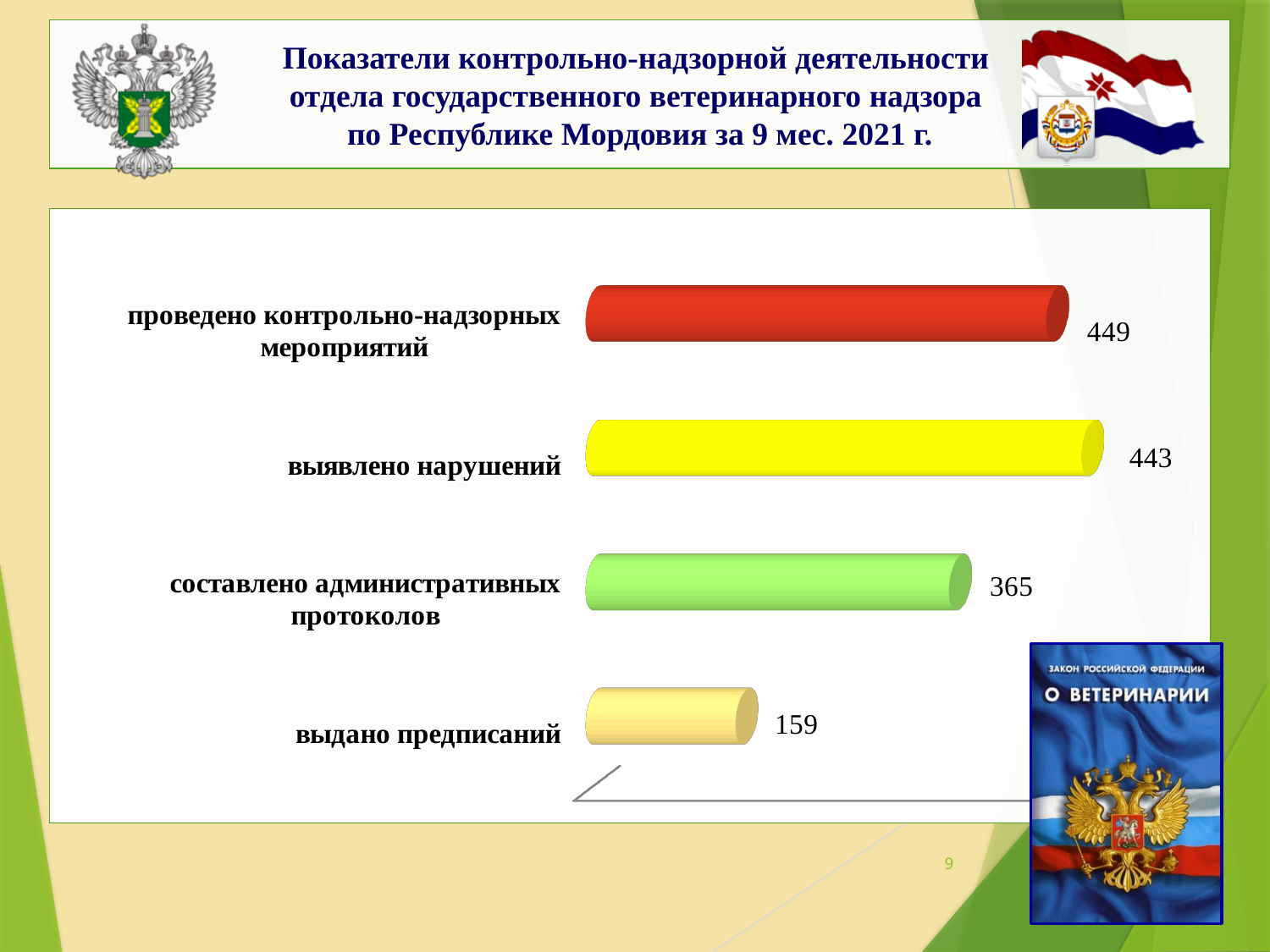
What value is shown for "выявлено нарушений"? 443 What is the difference between "проведено контрольно-надзорных мероприятий" and "выявлено нарушений"? 6 Which category has the lowest value? выдано предписаний What value is shown for "выдано предписаний"? 159 Which is larger: "составлено административных протоколов" or "выдано предписаний"? составлено административных протоколов What colour is the bar for "выявлено нарушений"? yellow What kind of chart is shown on the slide? bar chart What value is shown for "проведено контрольно-надзорных мероприятий"? 449 What value is shown for "составлено административных протоколов"? 365 What is the difference between "составлено административных протоколов" and "выдано предписаний"? 206 Which category has the highest value? проведено контрольно-надзорных мероприятий How many categories are shown in the chart? 4